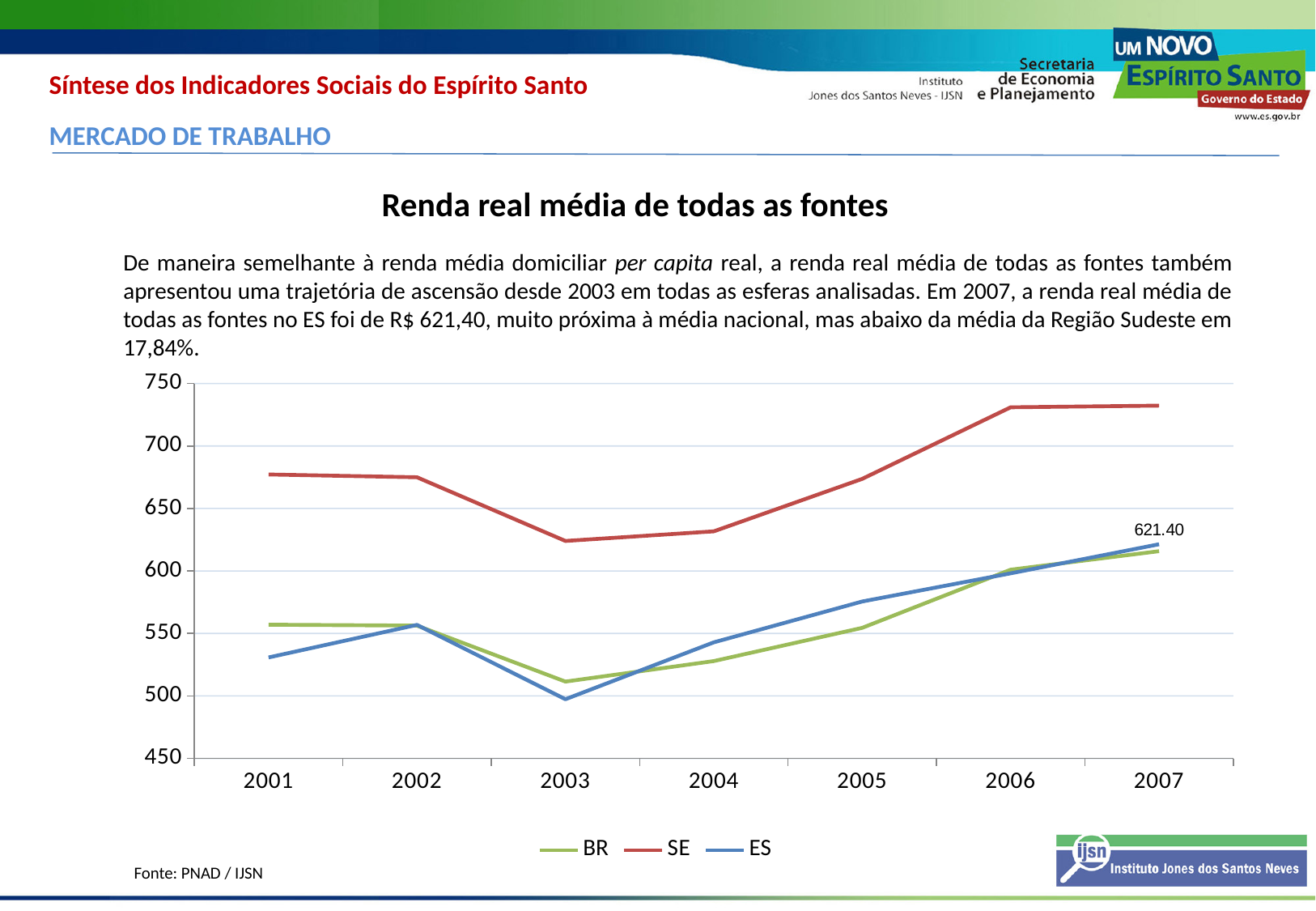
Is the value for SE in 2007 greater or less than 700? greater What is the value labelled for the ES series in 2007? 621.40 In which year does the ES series reach its lowest value? 2003 Is the value for ES in 2001 greater or less than 550? less How many series does the legend list? 3 In which year does the SE series reach its lowest value? 2003 What is the title of the chart? Renda real média de todas as fontes Which is larger in 2001, the BR value or the ES value? BR Which series has the highest value in 2007? SE Does the SE series rise or fall from 2003 to 2007? rise How many years are shown on the x axis? 7 What kind of chart is shown on the slide? line chart